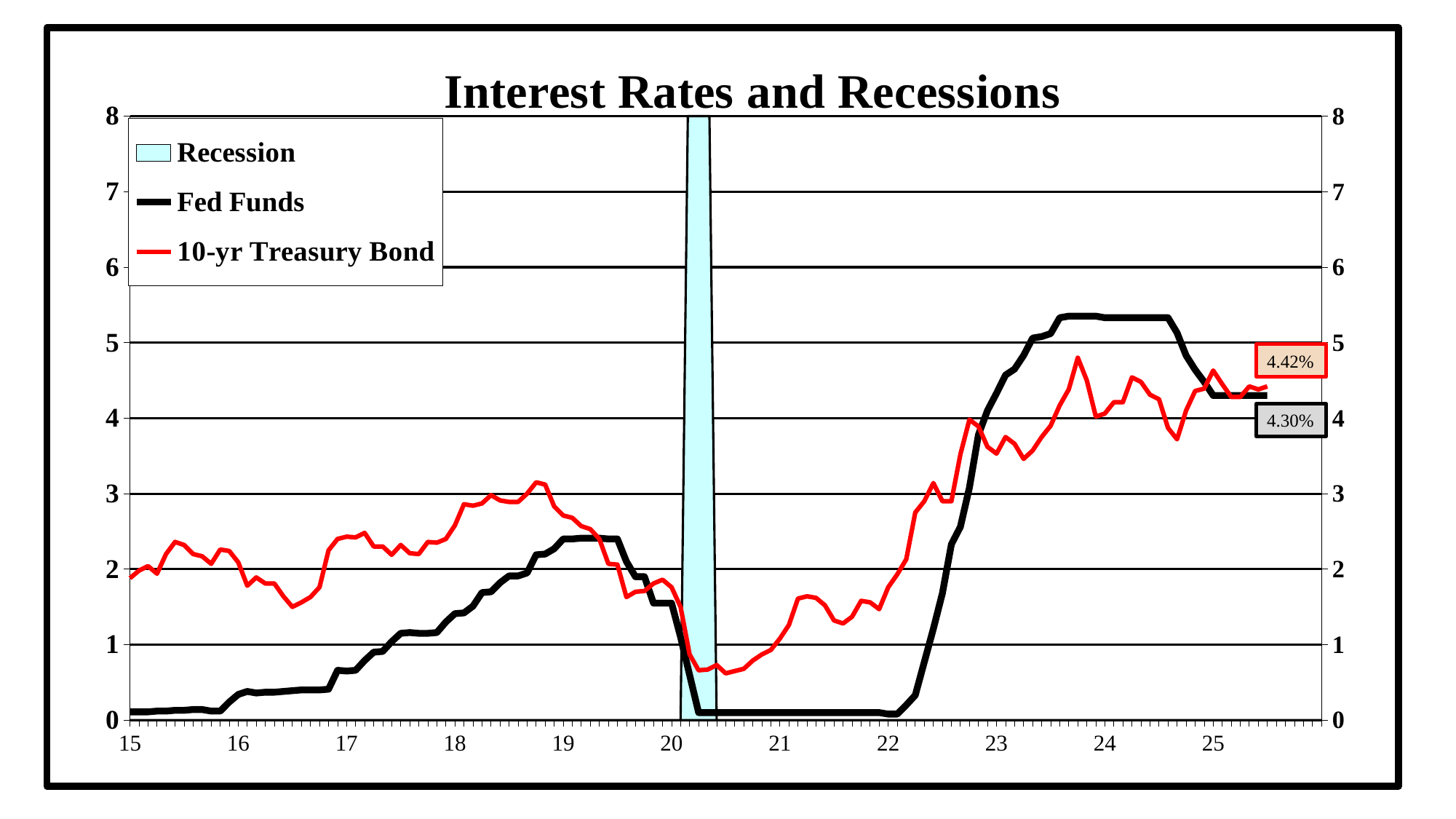
Does the Fed Funds line rise or fall between 22 and 23 on the x axis? rise What is the difference between the latest labelled 10-yr Treasury Bond value and the latest labelled Fed Funds value? 0.12% Is the Fed Funds value during 2021 greater or less than 1? less Is the 10-yr Treasury Bond value during 2016 greater or less than 3? less What kind of chart is shown on the slide? line chart What is the latest labelled value for Fed Funds? 4.30% Is the Fed Funds value at the start of 2024 greater or less than 5? greater What is the title of the chart? Interest Rates and Recessions Which series reaches the higher peak over the whole chart, Fed Funds or the 10-yr Treasury Bond? Fed Funds How many entries does the chart legend list? 3 At the end of the chart, which is higher: the 10-yr Treasury Bond or Fed Funds? 10-yr Treasury Bond What is the latest labelled value for the 10-yr Treasury Bond? 4.42%